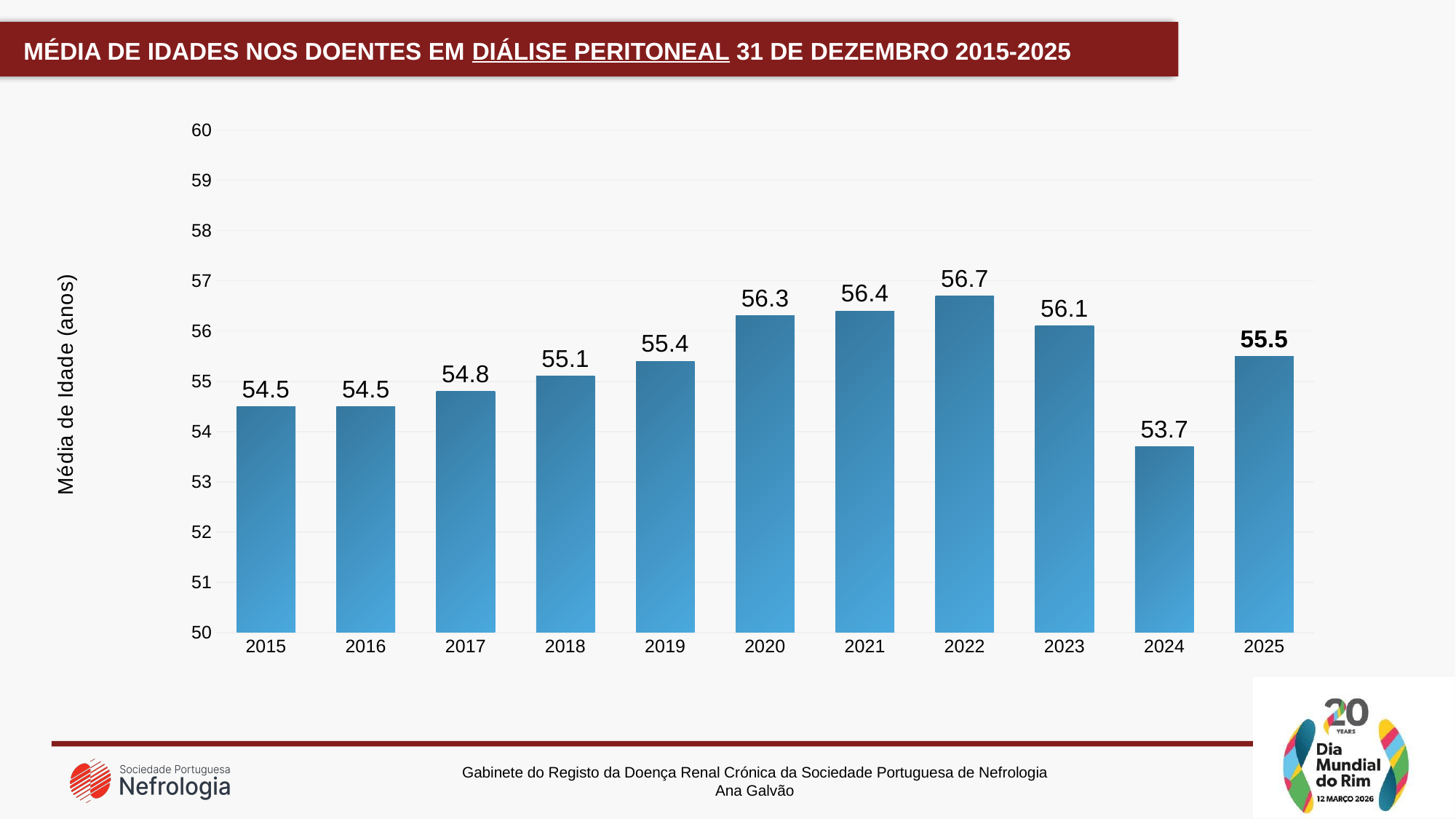
What is the difference between the mean age in 2025 and in 2015? 1.0 What is the mean age shown for 2025? 55.5 Is the mean age for 2020 greater or less than 56? greater What is the mean age shown for 2024? 53.7 What kind of chart is shown on the slide? Bar chart Which year has a higher mean age, 2019 or 2023? 2023 How many years are shown on the x axis? 11 Which year has the lowest mean age? 2024 What is the difference between the mean age in 2022 and in 2024? 3.0 What is the mean age of peritoneal dialysis patients in 2022? 56.7 Which year has the highest mean age? 2022 What is the label of the vertical axis? Média de Idade (anos)